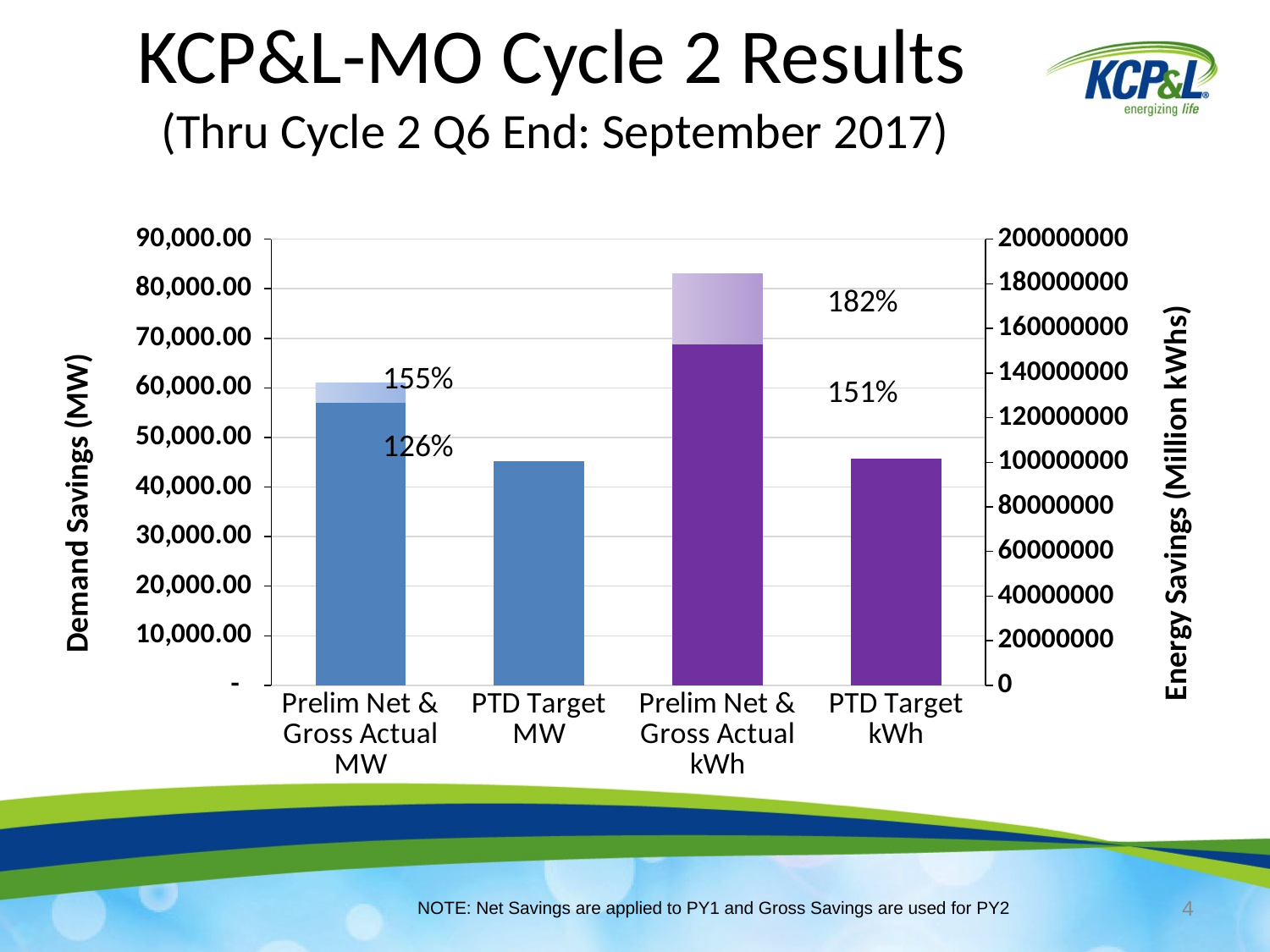
Is the bar for Prelim Net & Gross Actual MW taller or shorter than the bar for PTD Target MW? taller Which category has the tallest bar in the chart? Prelim Net & Gross Actual kWh Is the top of the Prelim Net & Gross Actual kWh bar greater or less than 160000000 on the right axis? greater Is the value for PTD Target MW greater or less than 50,000.00 on the left axis? less What is the higher percentage label shown next to the Prelim Net & Gross Actual MW bar? 155% Is the value for PTD Target MW greater or less than 40,000.00 on the left axis? greater How many categories are shown on the x axis of the chart? 4 What is the title of the left vertical axis of the chart? Demand Savings (MW) What is the title of the right vertical axis of the chart? Energy Savings (Million kWhs) What kind of chart is shown on the slide? bar chart What is the lower percentage label shown next to the Prelim Net & Gross Actual kWh bar? 151%